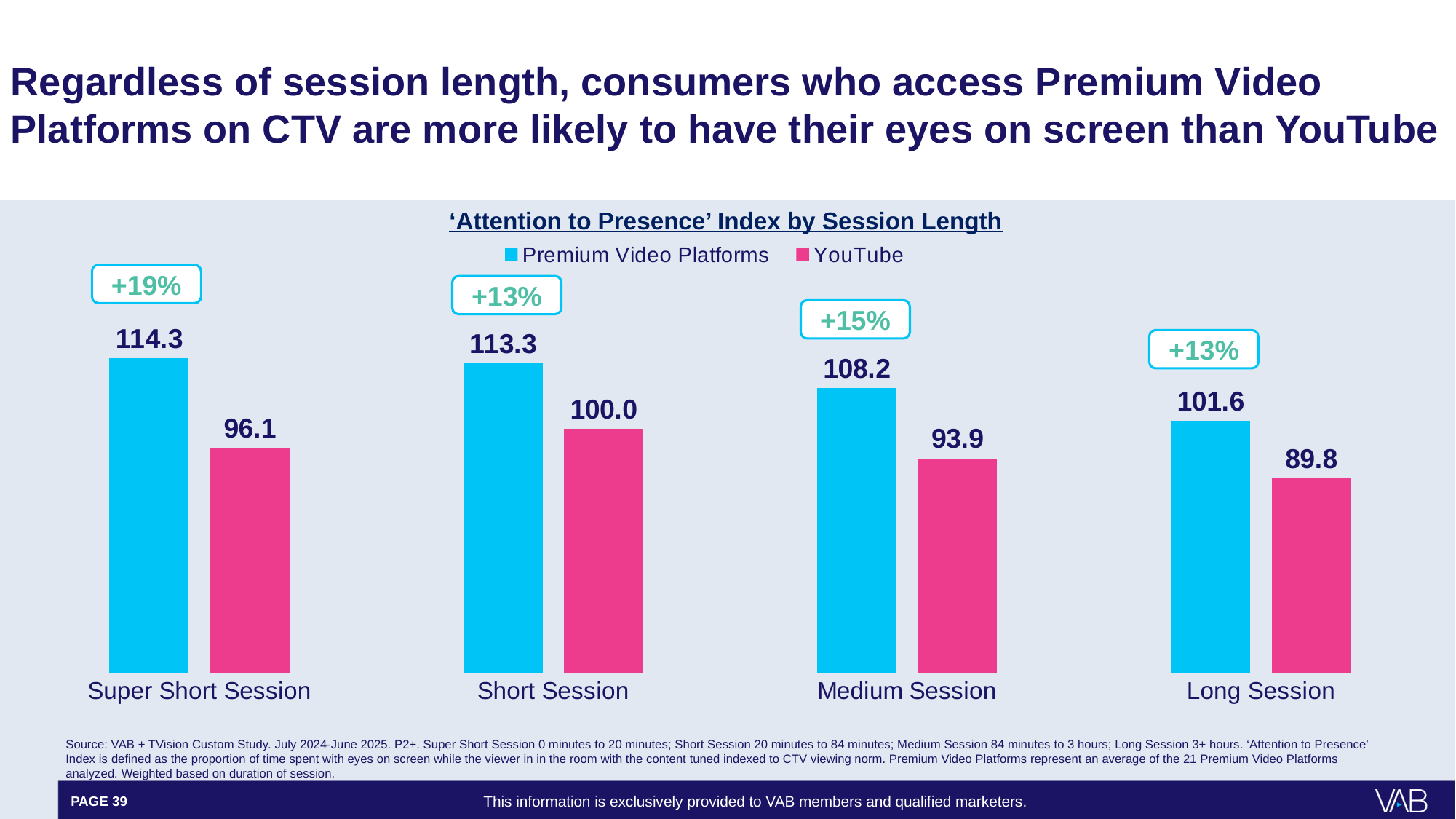
What percentage lift is shown above the Medium Session bars? +15% What kind of chart is shown on the slide? Bar chart What is the difference between the Premium Video Platforms and YouTube values in the Medium Session? 14.3 How many series does the legend list? 2 What is the 'Attention to Presence' Index for YouTube in the Long Session? 89.8 How many session length categories are shown on the chart? 4 What is the YouTube value for the Short Session? 100.0 Do the Premium Video Platforms values rise or fall from Super Short Session to Long Session? Fall Which session length has the lowest YouTube value? Long Session Which is larger in the Short Session: Premium Video Platforms or YouTube? Premium Video Platforms What is the 'Attention to Presence' Index for Premium Video Platforms in the Super Short Session? 114.3 Which session length has the highest Premium Video Platforms value? Super Short Session